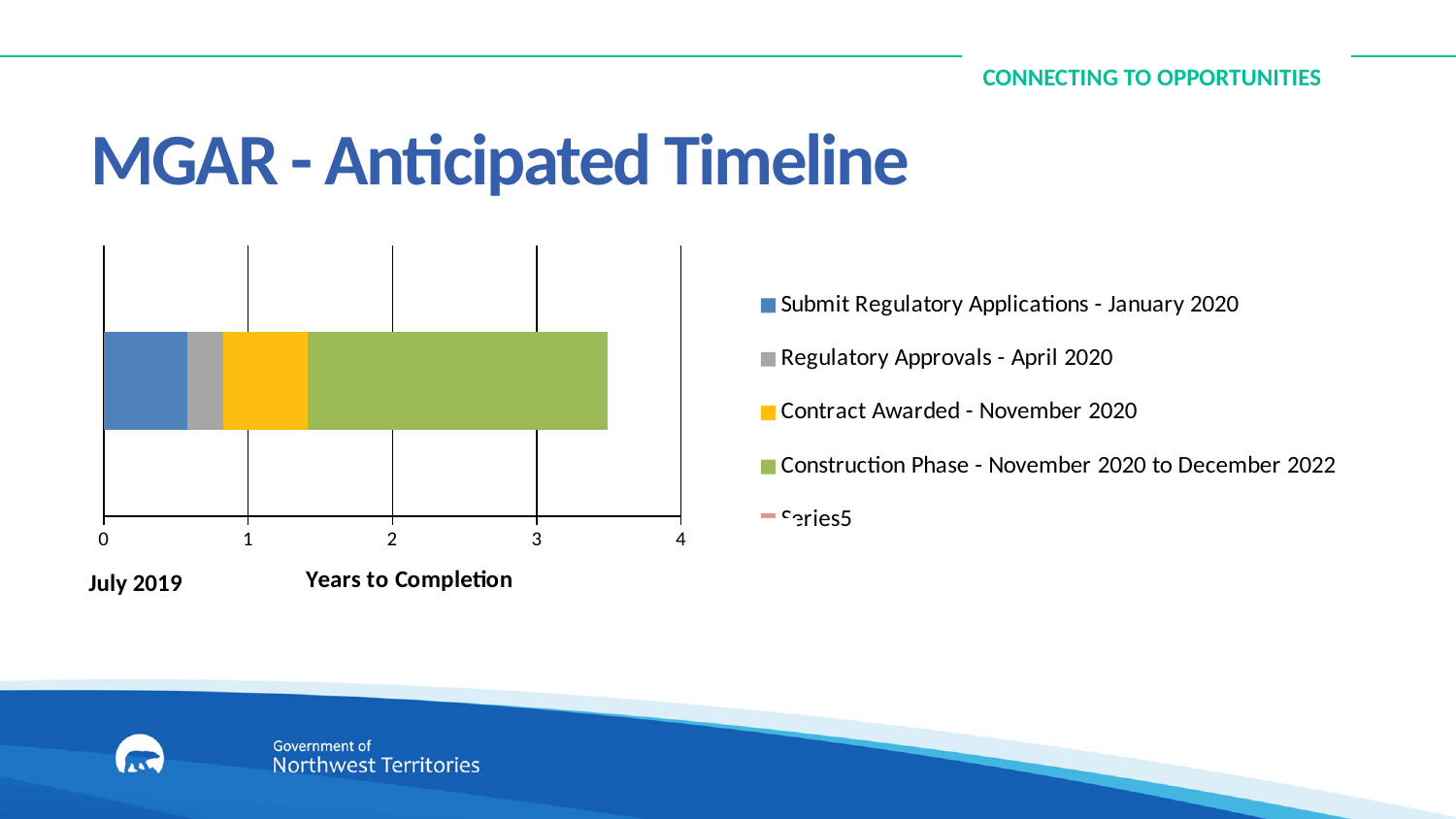
What kind of chart is shown on the slide? Stacked bar chart Is the total length of the stacked bar greater or less than 3 years? greater How many series does the legend list? 5 How many bars are plotted in the chart? 1 Which series occupies the longest segment of the bar? Construction Phase - November 2020 to December 2022 Is the total length of the stacked bar greater or less than 4 years? less Which of the visible segments of the bar is the shortest? Regulatory Approvals - April 2020 Which segment is longer: Construction Phase or Contract Awarded? Construction Phase Which segment is longer: Submit Regulatory Applications or Regulatory Approvals? Submit Regulatory Applications What colour represents the Construction Phase in the legend? Green What is the title of the x axis? Years to Completion